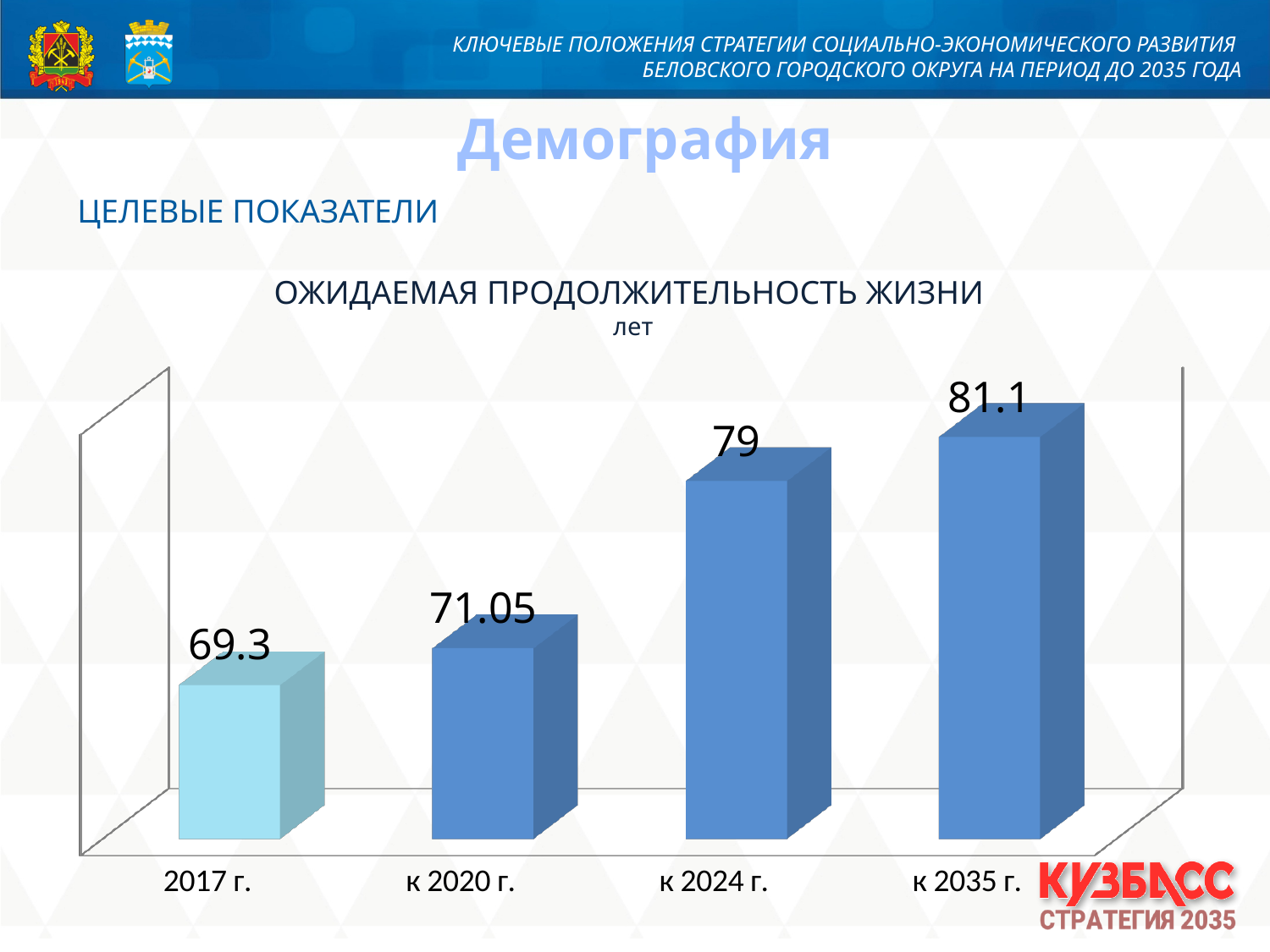
What value is shown for к 2020 г.? 71.05 Which category has the highest value? к 2035 г. What kind of chart is shown on the slide? bar chart What is the difference between the values for к 2035 г. and 2017 г.? 11.8 Do the values rise or fall from 2017 г. to к 2035 г.? rise How many categories are shown on the chart? 4 What value is shown for к 2024 г.? 79 Which is larger, the value for к 2020 г. or the value for к 2024 г.? к 2024 г. What is the expected life expectancy value shown for 2017 г.? 69.3 Which category has the lowest value? 2017 г. What is the difference between the values for к 2024 г. and к 2020 г.? 7.95 What value is shown for к 2035 г.? 81.1